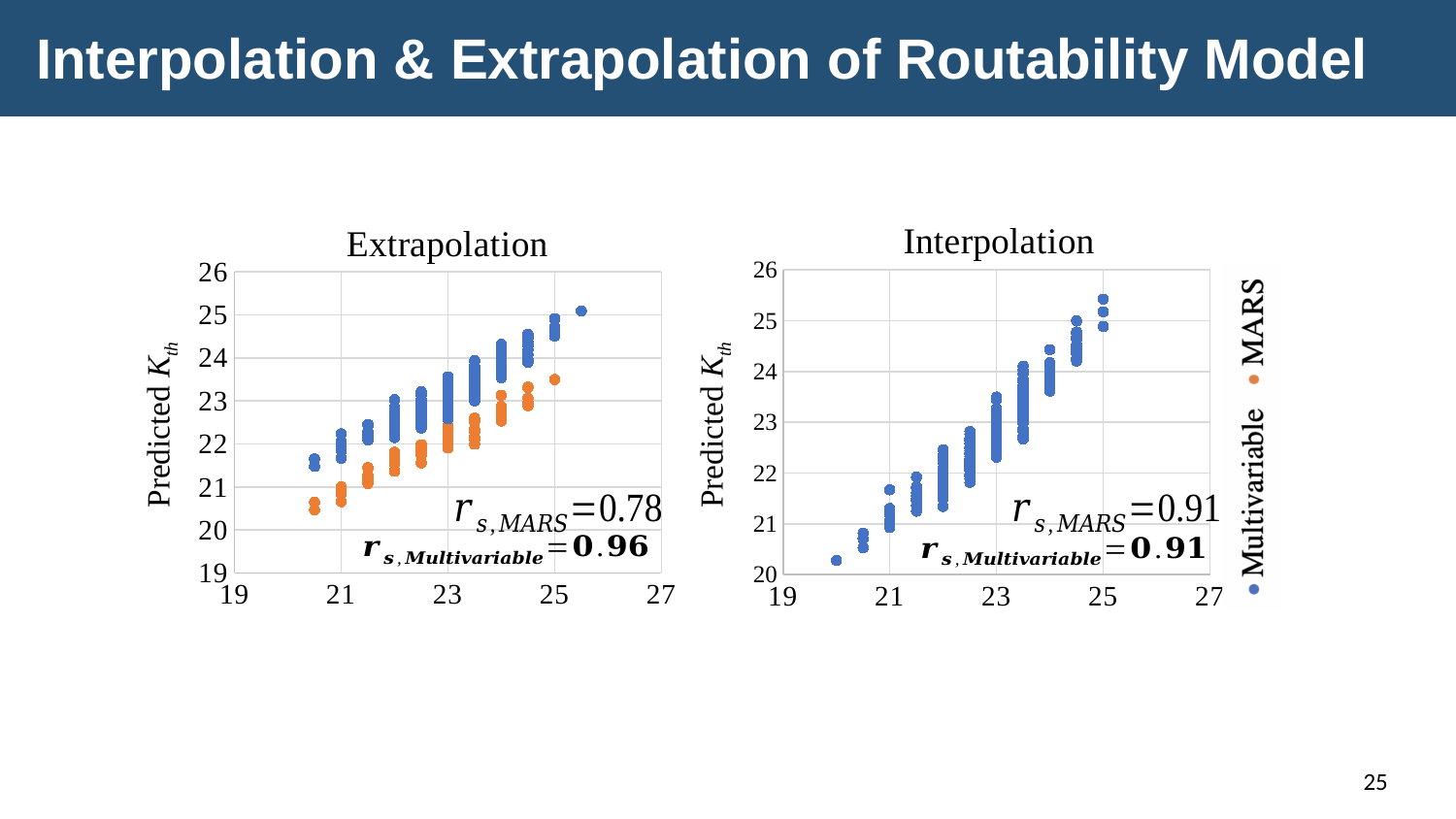
Which series is shown in orange in the legend? MARS In the Interpolation chart, what is the value of r_s,Multivariable printed on the chart? 0.91 In the Interpolation chart, what is the value of r_s,MARS printed on the chart? 0.91 How many series does the legend list for the charts? 2 In the Extrapolation chart, do the predicted values rise or fall as the x-axis value increases? rise In the Extrapolation chart, at x = 23, which series has the higher predicted values, MARS or Multivariable? Multivariable What kind of chart is the Extrapolation chart? scatter chart In the Extrapolation chart, what is the value of r_s,Multivariable printed on the chart? 0.96 What is the y-axis label of the Interpolation chart? Predicted Kth In the Interpolation chart, is the predicted value at x = 20 greater or less than 21? less In the Extrapolation chart, what is the value of r_s,MARS printed on the chart? 0.78